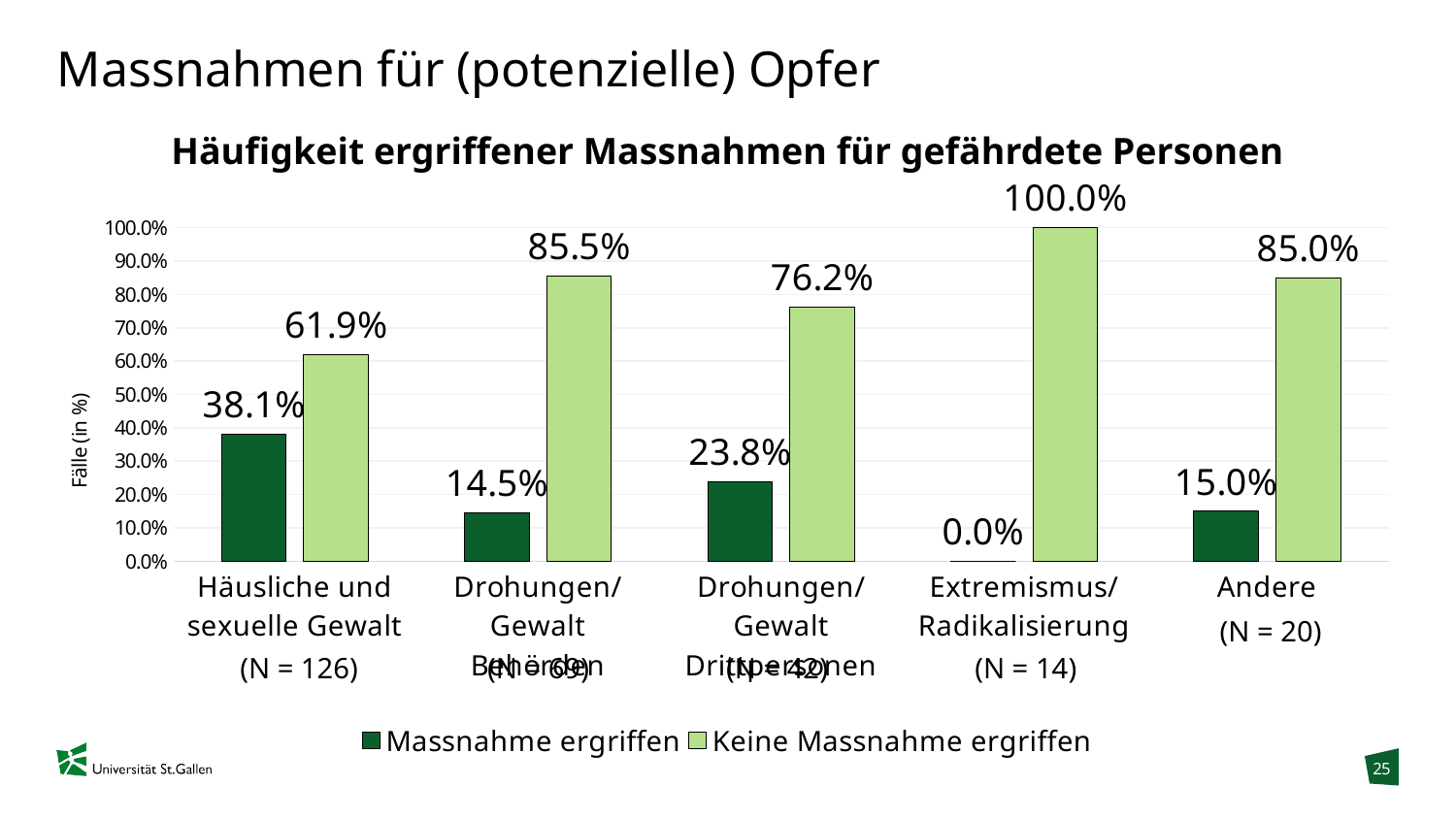
How many series does the legend list? 2 What is the value of 'Massnahme ergriffen' for 'Andere'? 15.0% What is the difference between 'Keine Massnahme ergriffen' and 'Massnahme ergriffen' for 'Häusliche und sexuelle Gewalt'? 23.8% Which category has the highest value for 'Massnahme ergriffen'? Häusliche und sexuelle Gewalt Which is larger for 'Andere': 'Massnahme ergriffen' or 'Keine Massnahme ergriffen'? Keine Massnahme ergriffen What is the sample size (N) shown for 'Häusliche und sexuelle Gewalt'? N = 126 How many categories are shown on the x axis? 5 What type of chart is shown on the slide? bar chart What is the value of 'Keine Massnahme ergriffen' for 'Extremismus/Radikalisierung'? 100.0% Which category has the lowest value for 'Massnahme ergriffen'? Extremismus/Radikalisierung What is the title of the chart? Häufigkeit ergriffener Massnahmen für gefährdete Personen What is the value of 'Massnahme ergriffen' for 'Häusliche und sexuelle Gewalt'? 38.1%